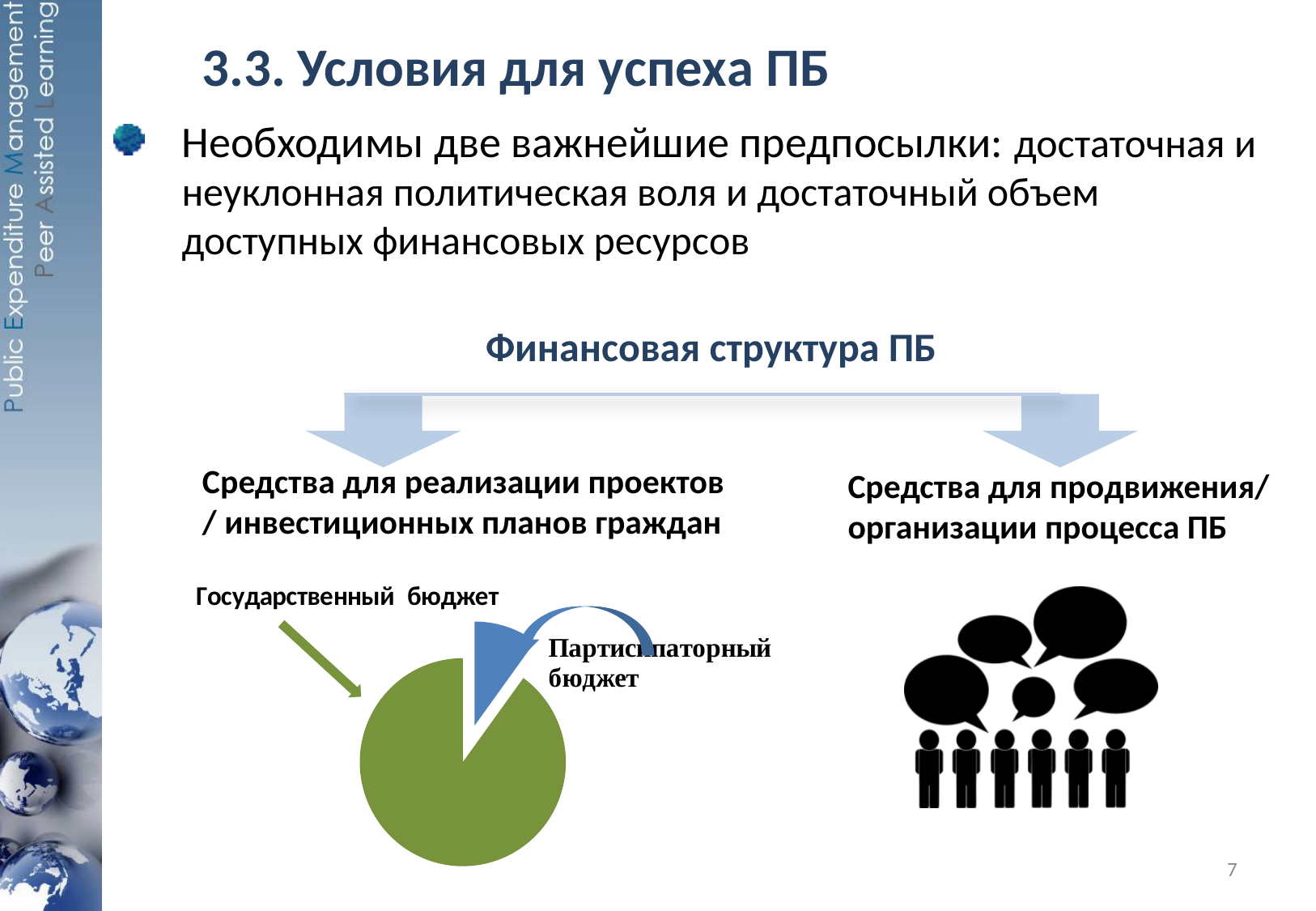
What kind of chart is shown on the slide? pie chart What colour is the Государственный бюджет slice of the pie chart? green What colour is the Партисипаторный бюджет slice of the pie chart? blue Which slice of the pie chart is the largest? Государственный бюджет Which is larger in the pie chart, Государственный бюджет or Партисипаторный бюджет? Государственный бюджет How many slices does the pie chart have? 2 Which slice of the pie chart is the smallest? Партисипаторный бюджет